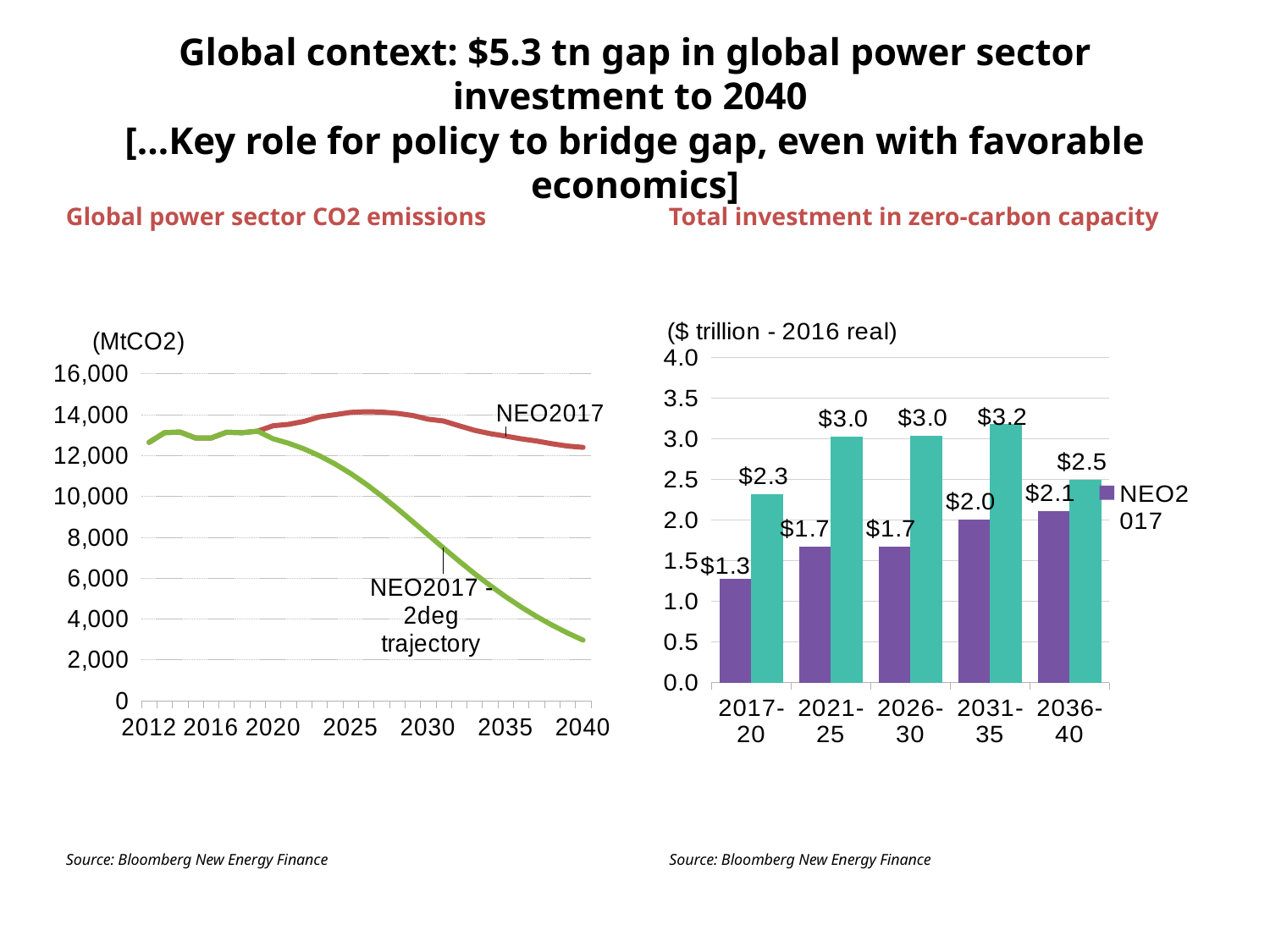
In the 'Total investment in zero-carbon capacity' chart, how many periods are shown on the x axis? 5 In the 'Total investment in zero-carbon capacity' chart, what is the NEO2017 value for 2017-20? $1.3 In the 'Total investment in zero-carbon capacity' chart, what is the difference between the NEO2017 values for 2036-40 and 2017-20? $0.8 In the 'Total investment in zero-carbon capacity' chart, which period has the highest NEO2017 value? 2036-40 In the 'Total investment in zero-carbon capacity' chart, what is the NEO2017 value for 2031-35? $2.0 What type of chart is the 'Total investment in zero-carbon capacity' chart? bar chart In the 'Global power sector CO2 emissions' chart, is the NEO2017 - 2deg trajectory value in 2040 greater or less than 4,000? less What type of chart is the 'Global power sector CO2 emissions' chart? line chart In the 'Total investment in zero-carbon capacity' chart, which period has the lowest NEO2017 value? 2017-20 In the 'Global power sector CO2 emissions' chart, does the NEO2017 - 2deg trajectory line rise or fall between 2020 and 2040? fall In the 'Global power sector CO2 emissions' chart, what unit is shown for the y axis? MtCO2 In the 'Total investment in zero-carbon capacity' chart, is the NEO2017 value for 2031-35 larger or smaller than the NEO2017 value for 2021-25? larger